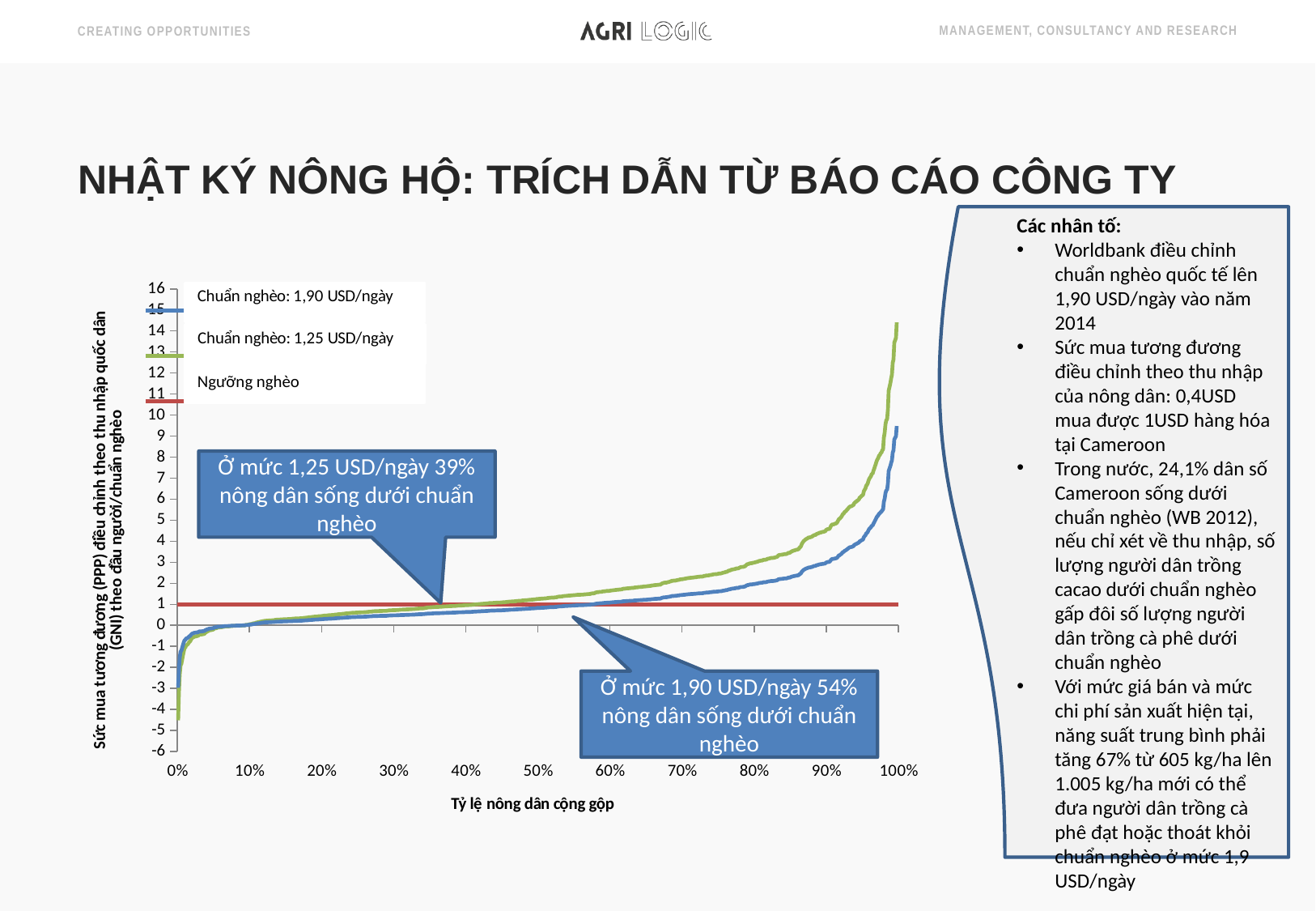
Is the value of the green 'Chuẩn nghèo: 1,25 USD/ngày' line at 100% greater or less than 10? greater What kind of chart is shown on the slide? line chart According to the callout, what share of farmers live below the poverty line at 1,90 USD/ngày? 54% According to the callout, what share of farmers live below the poverty line at 1,25 USD/ngày? 39% Which legend entry is drawn in red? Ngưỡng nghèo Is the value of the blue 'Chuẩn nghèo: 1,90 USD/ngày' line at 0% greater or less than 0? less Do the blue and green lines rise or fall as the x axis goes from 0% to 100%? rise Is the value of the blue 'Chuẩn nghèo: 1,90 USD/ngày' line at 100% greater or less than 5? greater At what y-axis value does the red 'Ngưỡng nghèo' line sit? 1 At 90% on the x axis, which line is higher: the green 'Chuẩn nghèo: 1,25 USD/ngày' line or the blue 'Chuẩn nghèo: 1,90 USD/ngày' line? green (Chuẩn nghèo: 1,25 USD/ngày) What is the label of the x axis of the chart? Tỷ lệ nông dân cộng gộp How many series does the chart legend list? 3